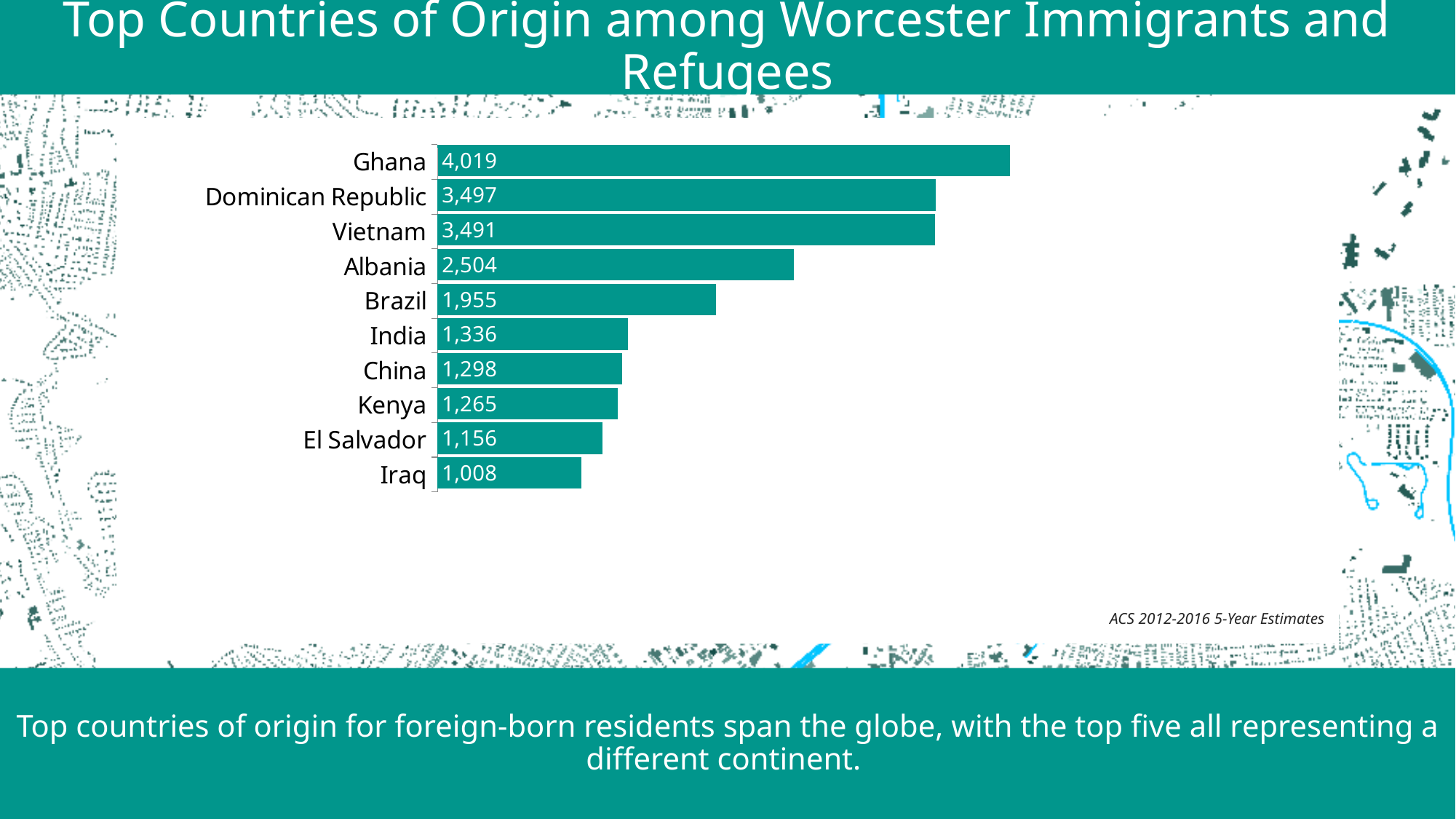
What is the difference between the values for Brazil and India? 619 What data source is cited below the chart? ACS 2012-2016 5-Year Estimates Which is larger, the value for China or the value for Kenya? China What is the value for Albania? 2,504 What is the difference between the values for Ghana and Dominican Republic? 522 What is the value for El Salvador? 1,156 Which country has the lowest value? Iraq Which is larger, the value for Albania or the value for Brazil? Albania What kind of chart is shown on the slide? Bar chart How many countries are shown in the chart? 10 Which country has the highest value? Ghana What is the value for Ghana? 4,019